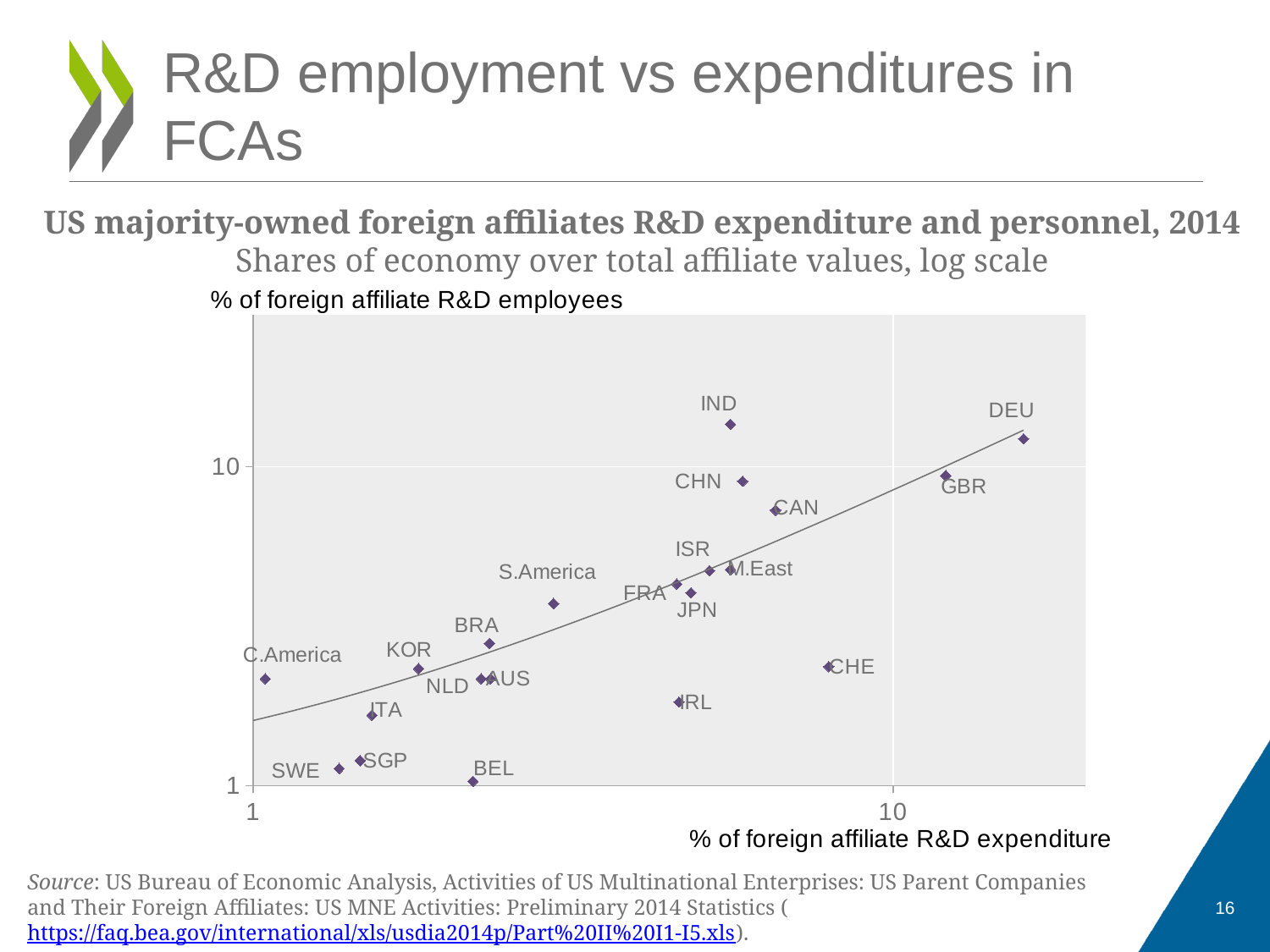
Which economy has the highest % of foreign affiliate R&D employees? IND Is the % of foreign affiliate R&D expenditure for DEU greater or less than 10? greater Which economy has the highest % of foreign affiliate R&D expenditure? DEU What kind of chart is shown on the slide? scatter plot Is the % of foreign affiliate R&D employees for CAN greater or less than 10? less Is the % of foreign affiliate R&D expenditure for CHE greater or less than 10? less How many economies are plotted as points on the chart? 21 Which economy has the lowest % of foreign affiliate R&D expenditure? C.America What is the label of the horizontal axis of the chart? % of foreign affiliate R&D expenditure Which has a higher % of foreign affiliate R&D employees, IND or CHN? IND Which economy has the lowest % of foreign affiliate R&D employees? BEL